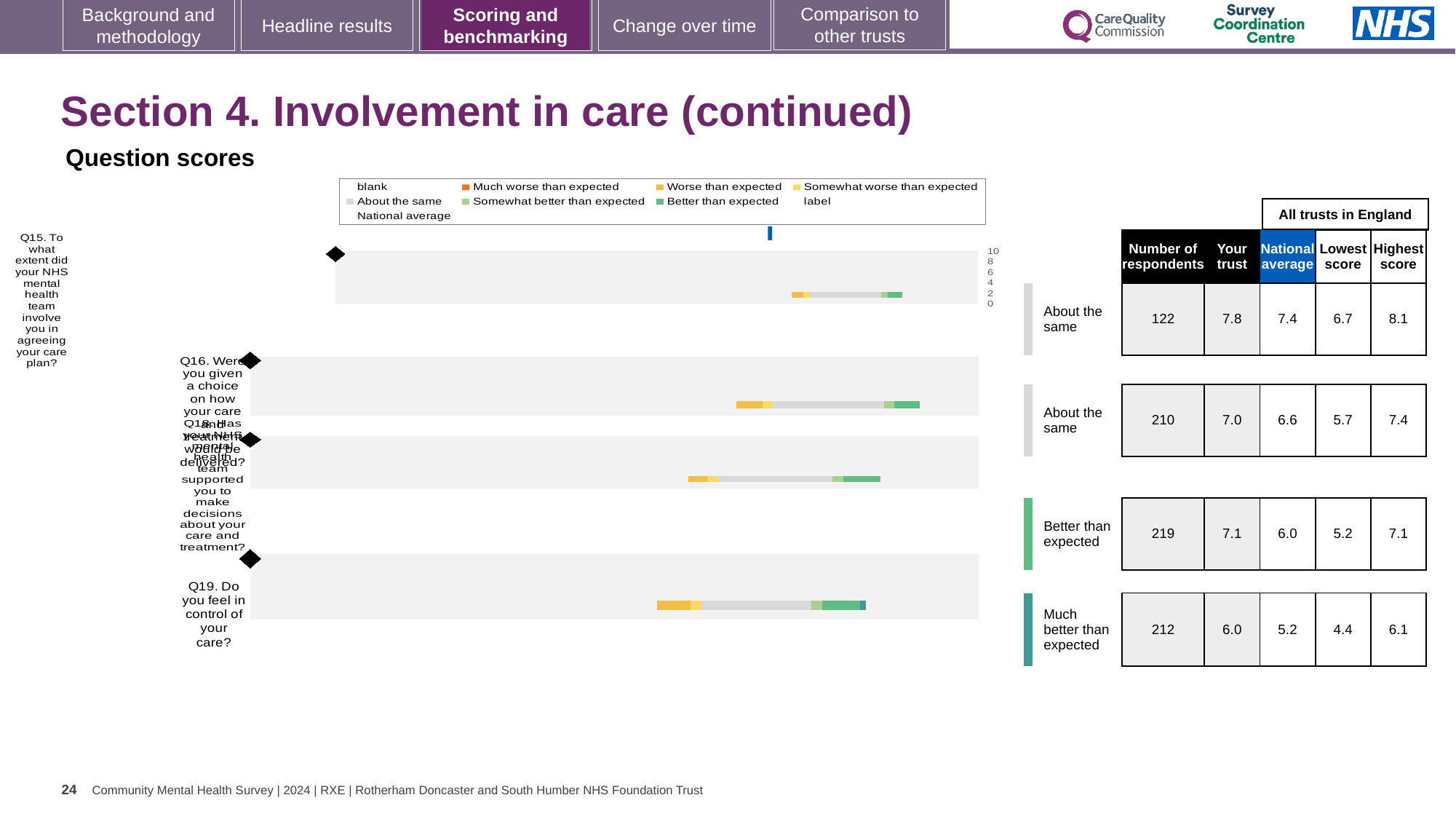
In the table next to the chart, what is the 'Your trust' score for Q15 (involvement in agreeing your care plan)? 7.8 In the table next to the chart, what is the national average for Q19 (feeling in control of your care)? 5.2 Is the 'Your trust' score for Q16 larger than its national average? Yes, 7.0 vs 6.6 What benchmark category is shown for Q19 (feeling in control of your care)? Much better than expected In the table next to the chart, how many respondents answered Q18? 219 What kind of chart is used to show the question scores on this slide? bar chart How many questions (bars) are plotted in the question scores chart? 4 Which of the four questions has the highest 'Your trust' score in the table? Q15 What is the difference between the 'Your trust' score and the national average for Q18? 1.1 Which of the four questions has the lowest 'Your trust' score in the table? Q19 What is the highest score among all trusts in England for Q16? 7.4 What is the heading above the 'National average', 'Lowest score' and 'Highest score' columns? All trusts in England